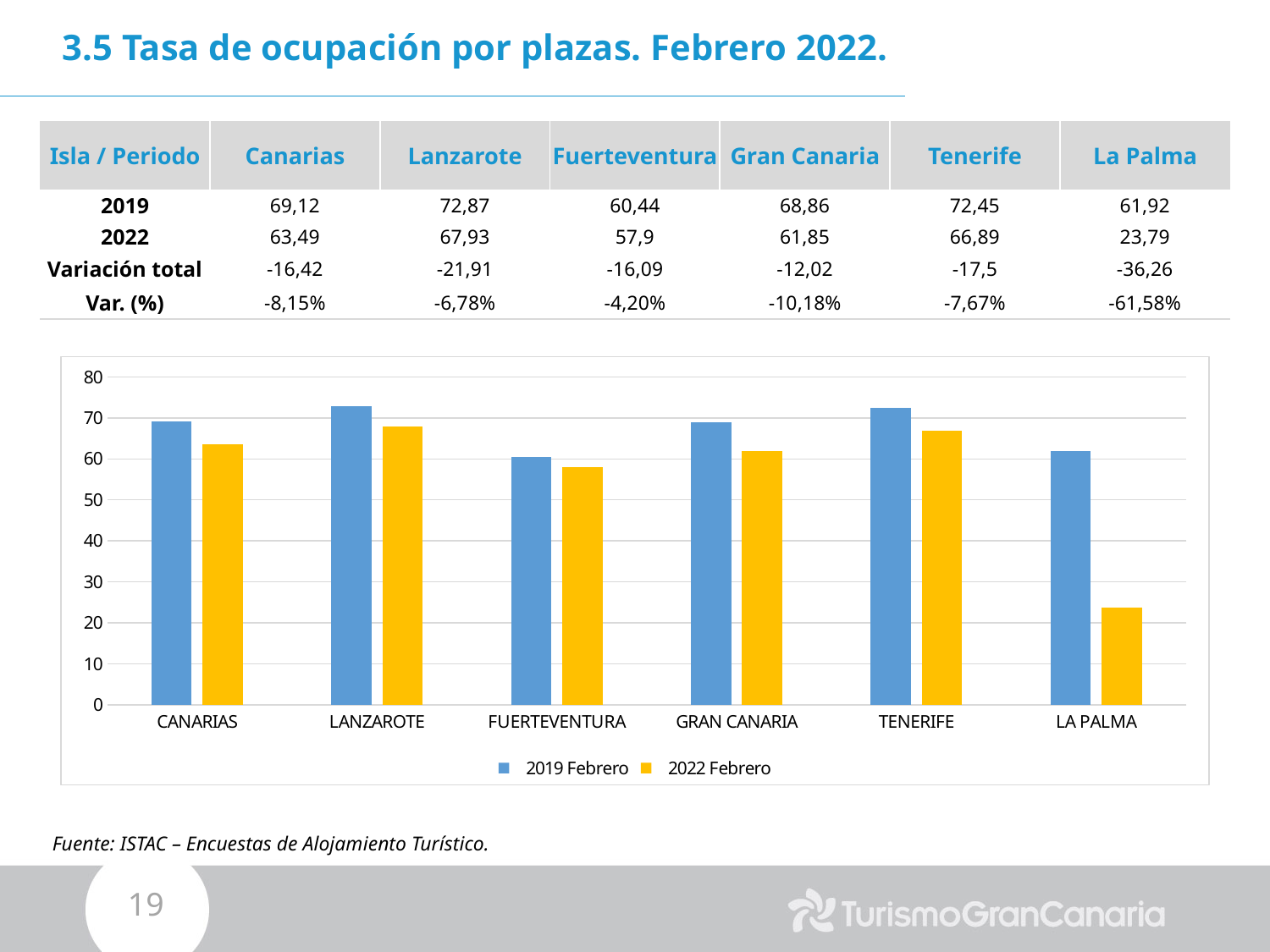
In the chart, which is larger for GRAN CANARIA: the 2019 Febrero bar or the 2022 Febrero bar? 2019 Febrero Is the 2022 Febrero value for LA PALMA greater or less than 30? less Is the 2019 Febrero value for TENERIFE greater or less than 70? greater Which category has the highest 2019 Febrero value in the chart? LANZAROTE According to the slide, what is the 2022 occupancy rate for Lanzarote? 67,93 Is the 2022 Febrero value for FUERTEVENTURA greater or less than 60? less How many series does the chart legend list? 2 How many island categories are shown on the x axis of the chart? 6 According to the slide, what is the 2019 occupancy rate for La Palma? 61,92 Which colour represents the 2022 Febrero series in the chart? yellow What kind of chart is shown on the slide? bar chart Which category has the lowest 2022 Febrero value in the chart? LA PALMA